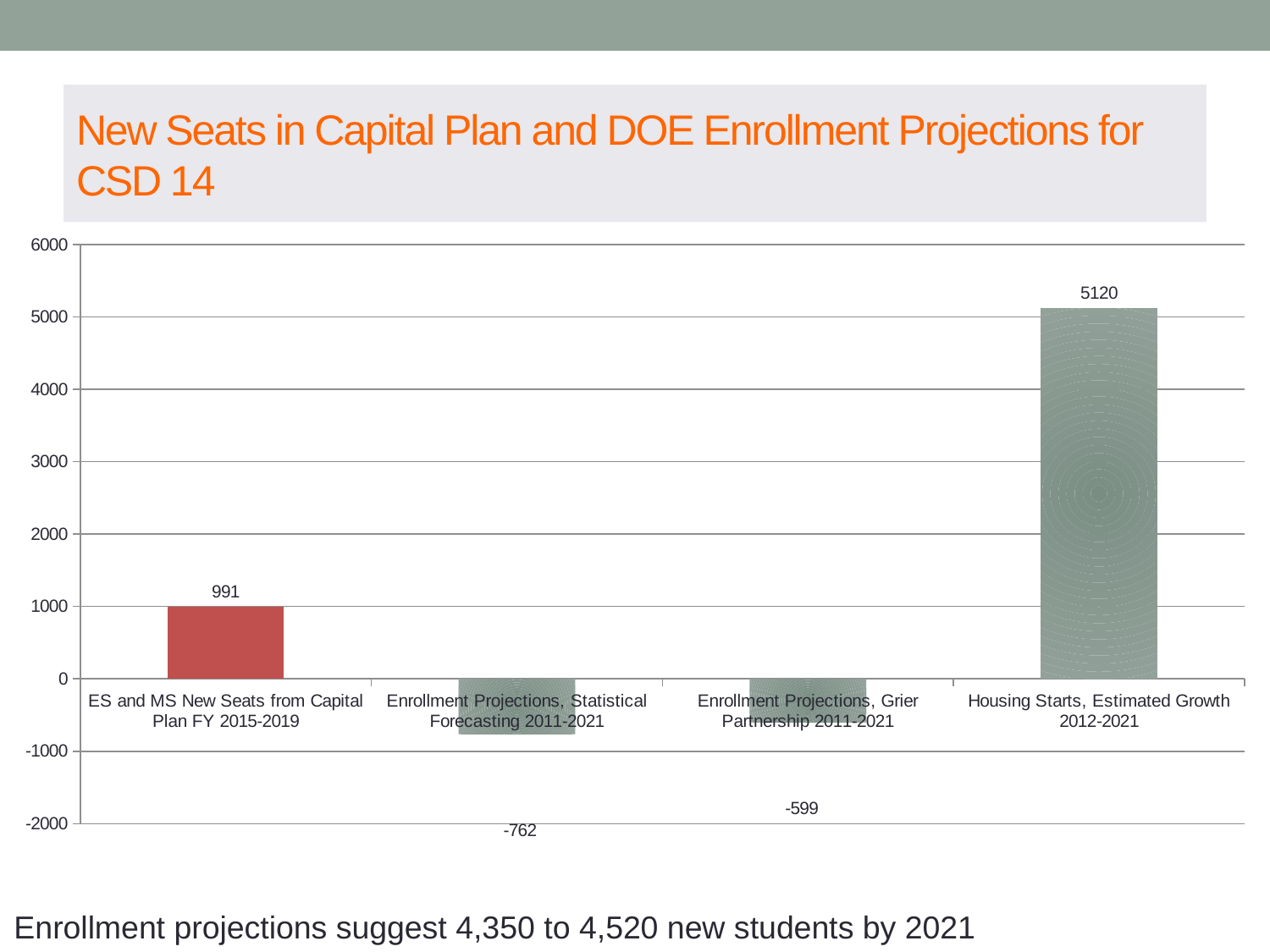
How many categories are shown in the chart? 4 What is the value for Housing Starts, Estimated Growth 2012-2021? 5120 What is the value for Enrollment Projections, Statistical Forecasting 2011-2021? -762 What is the difference between the value for Enrollment Projections, Grier Partnership 2011-2021 and the value for Enrollment Projections, Statistical Forecasting 2011-2021? 163 Which is larger: the value for Enrollment Projections, Statistical Forecasting 2011-2021 or the value for Enrollment Projections, Grier Partnership 2011-2021? Enrollment Projections, Grier Partnership 2011-2021 Which category has the lowest value? Enrollment Projections, Statistical Forecasting 2011-2021 What is the value for ES and MS New Seats from Capital Plan FY 2015-2019? 991 What is the value for Enrollment Projections, Grier Partnership 2011-2021? -599 What kind of chart is shown on the slide? Bar chart What is the title of the slide? New Seats in Capital Plan and DOE Enrollment Projections for CSD 14 Which category has the highest value? Housing Starts, Estimated Growth 2012-2021 What is the difference between the value for Housing Starts, Estimated Growth 2012-2021 and the value for ES and MS New Seats from Capital Plan FY 2015-2019? 4129